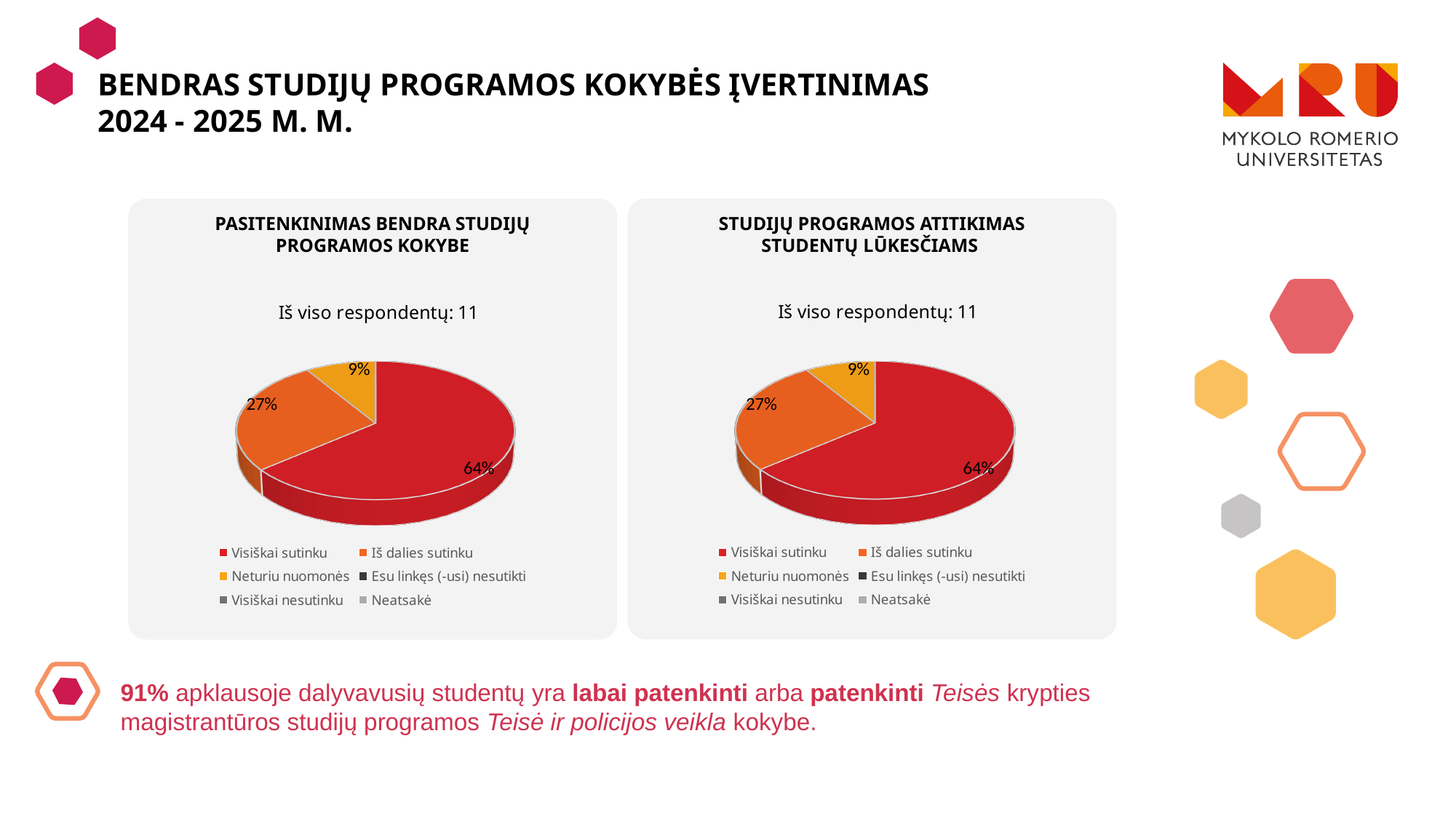
In the chart titled "Studijų programos atitikimas studentų lūkesčiams", which response has the largest share? Visiškai sutinku In the chart titled "Pasitenkinimas bendra studijų programos kokybe", which of the visible slices has the smallest share? Neturiu nuomonės In the chart titled "Pasitenkinimas bendra studijų programos kokybe", what colour is the "Visiškai sutinku" slice? Red How many respondents in total are reported for the chart titled "Studijų programos atitikimas studentų lūkesčiams"? 11 In the chart titled "Studijų programos atitikimas studentų lūkesčiams", which is larger: the share for "Iš dalies sutinku" or for "Neturiu nuomonės"? Iš dalies sutinku In the chart titled "Studijų programos atitikimas studentų lūkesčiams", what share of respondents answered "Neturiu nuomonės"? 9% How many slices with a printed percentage are visible in the chart titled "Pasitenkinimas bendra studijų programos kokybe"? 3 How many entries does the legend of the chart titled "Studijų programos atitikimas studentų lūkesčiams" list? 6 What type of chart is used in the left panel, "Pasitenkinimas bendra studijų programos kokybe"? Pie chart In the chart titled "Pasitenkinimas bendra studijų programos kokybe", what share of respondents answered "Iš dalies sutinku"? 27% In the chart titled "Pasitenkinimas bendra studijų programos kokybe", what share of respondents answered "Visiškai sutinku"? 64% In the chart titled "Pasitenkinimas bendra studijų programos kokybe", what is the difference in percentage points between "Visiškai sutinku" and "Iš dalies sutinku"? 37 percentage points